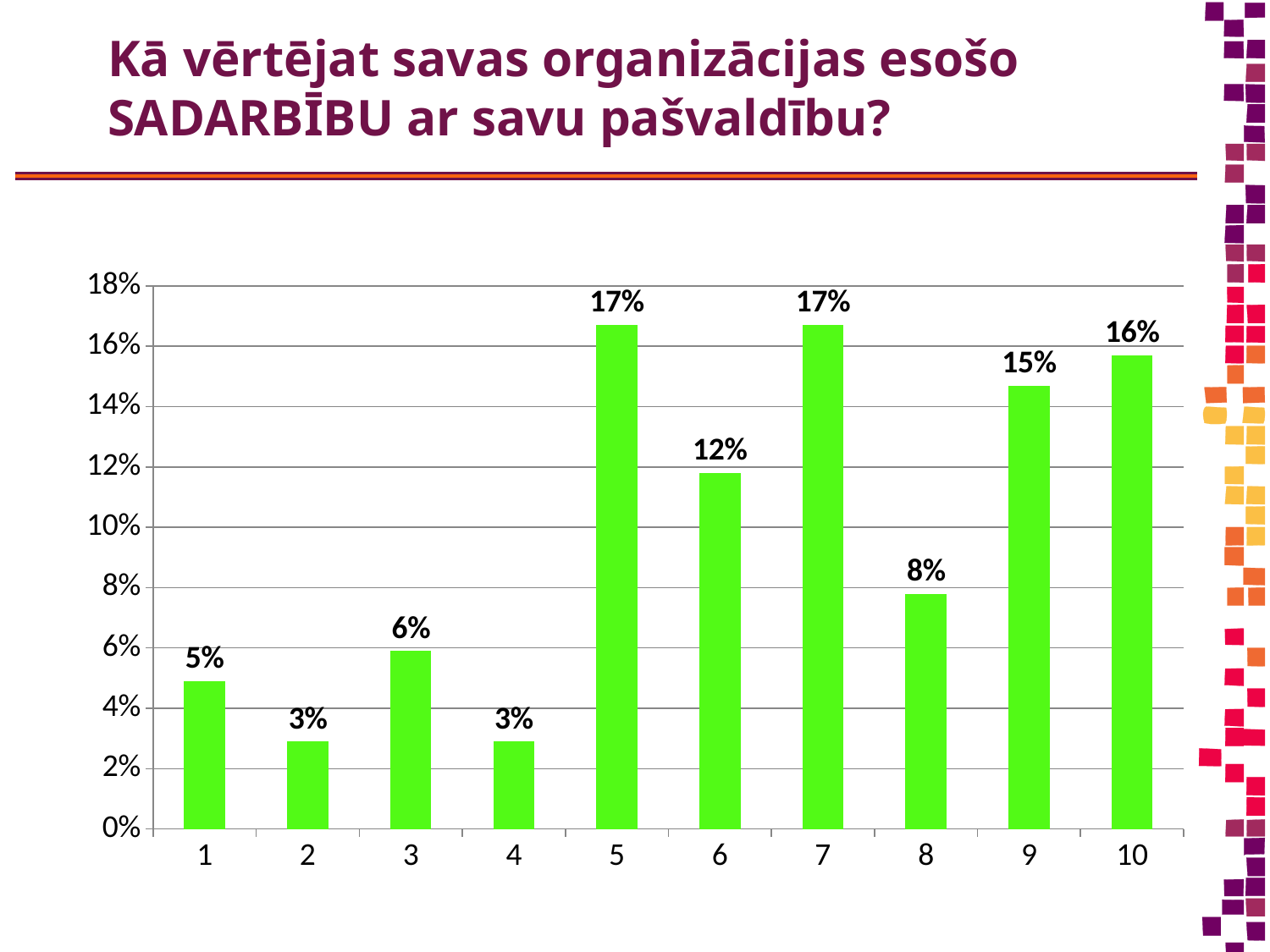
How many categories are shown on the x axis? 10 What colour are the bars in the chart? Green What is the value for category 5? 17% Is the value for category 9 greater or less than 14%? greater Which has a larger value, category 6 or category 8? Category 6 Which has a larger value, category 1 or category 3? Category 3 What is the value for category 8? 8% What is the difference between the values for category 7 and category 8? 9% What is the difference between the values for category 6 and category 3? 6% What is the value for category 10? 16% What is the value for category 1? 5% What kind of chart is shown on the slide? Bar chart